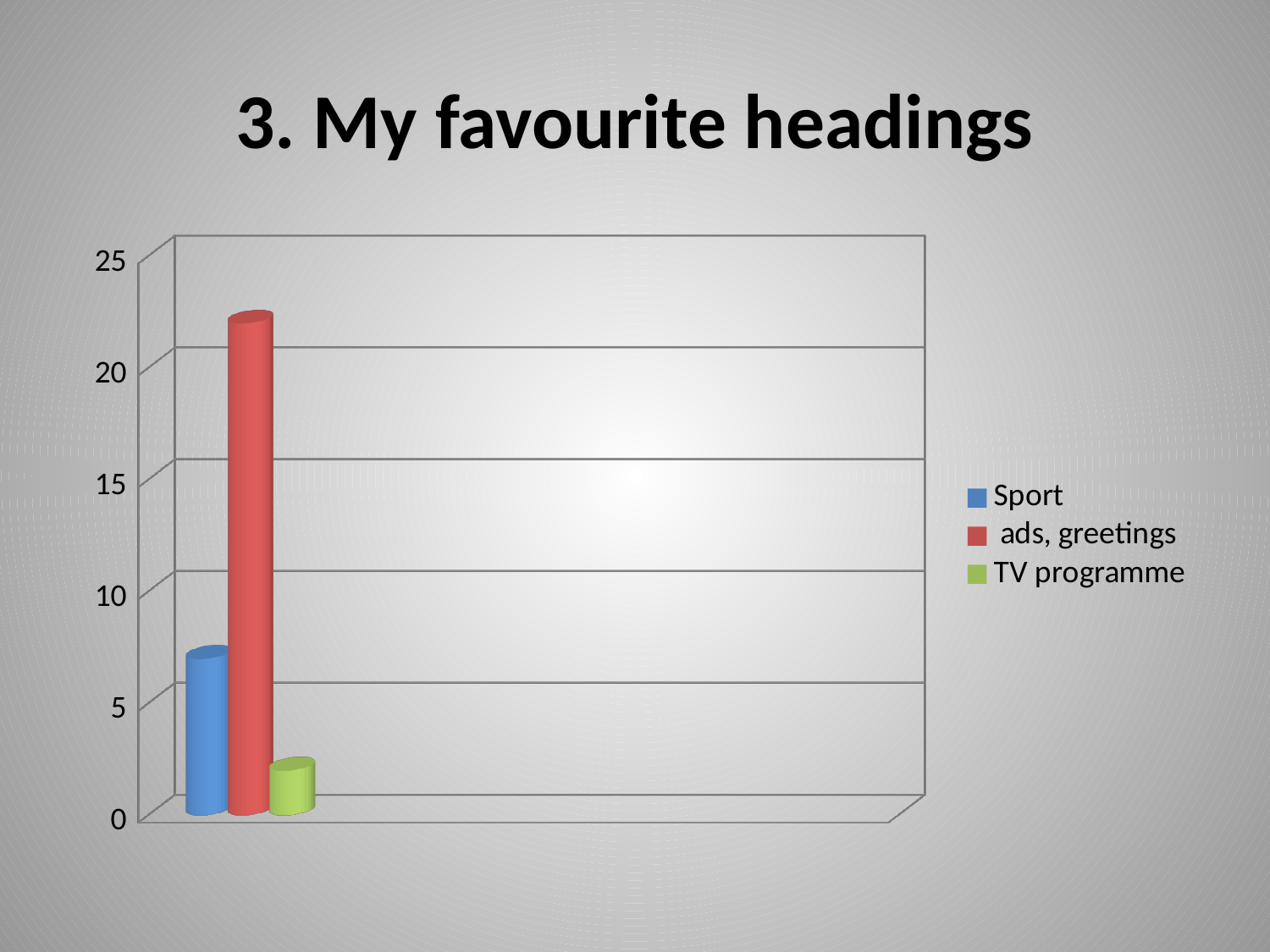
What is the title of the slide? 3. My favourite headings What kind of chart is shown on the slide? bar chart Which is larger, the value for Sport or the value for TV programme? Sport Which series has the lowest value? TV programme Is the value for Sport greater or less than 5? greater How many series does the legend list? 3 Which series has the highest value? ads, greetings Is the value for TV programme greater or less than 5? less Is the value for ads, greetings greater or less than 20? greater Which is larger, the value for ads, greetings or the value for Sport? ads, greetings How many bars are plotted in the chart? 3